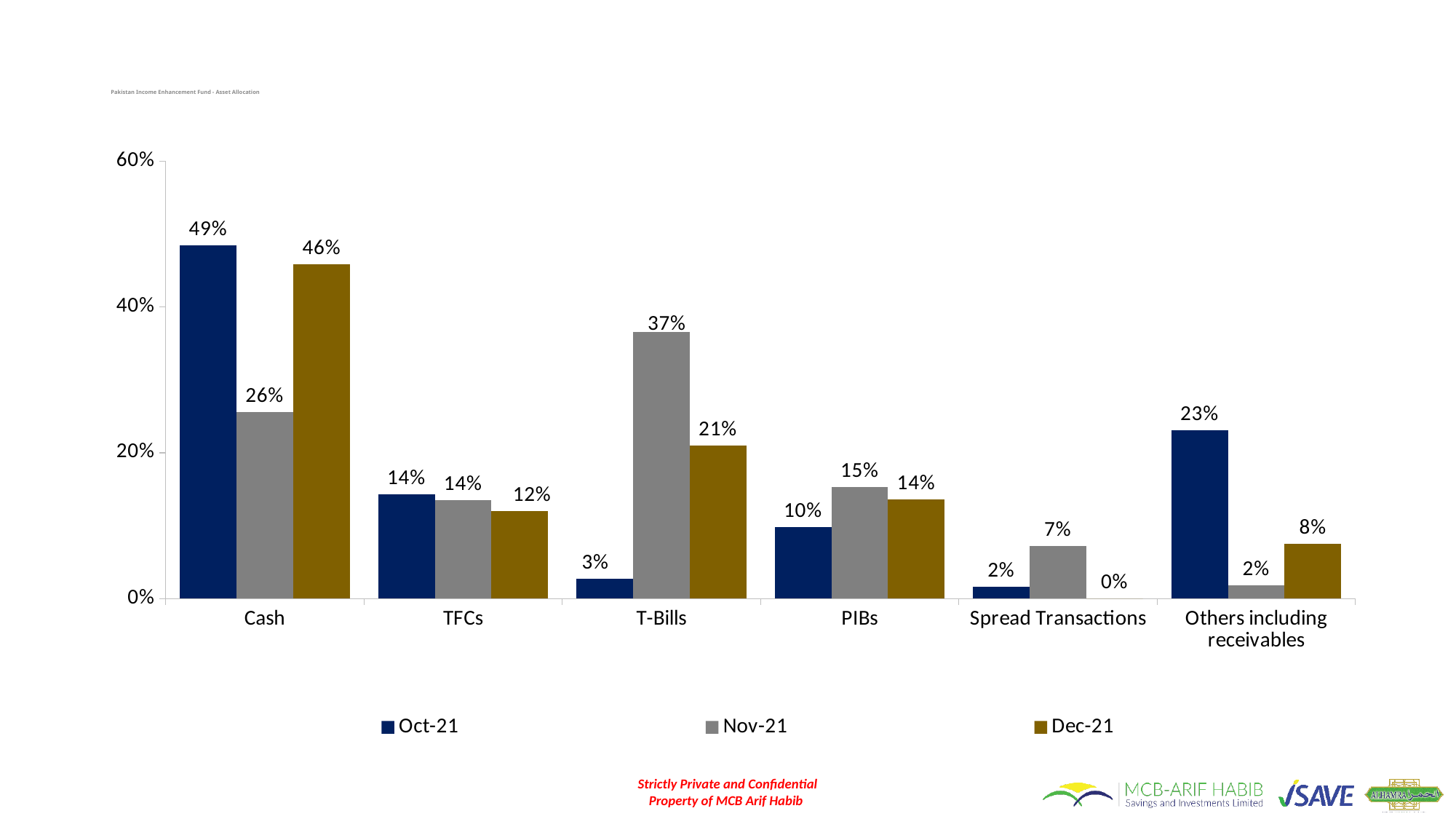
What is the Dec-21 value for Spread Transactions? 0% Which category has the lowest Oct-21 value? Spread Transactions What is the difference between the Oct-21 and Nov-21 values for Cash? 23% What is the Nov-21 value for T-Bills? 37% Which is larger for PIBs: the Oct-21 value or the Nov-21 value? Nov-21 Which series is shown in gray in the legend? Nov-21 What kind of chart is shown on the slide? Bar chart Which category has the highest Nov-21 value? T-Bills What is the Dec-21 value for Others including receivables? 8% How many categories are shown on the x axis? 6 How many series does the legend list? 3 What is the Oct-21 value for Cash? 49%